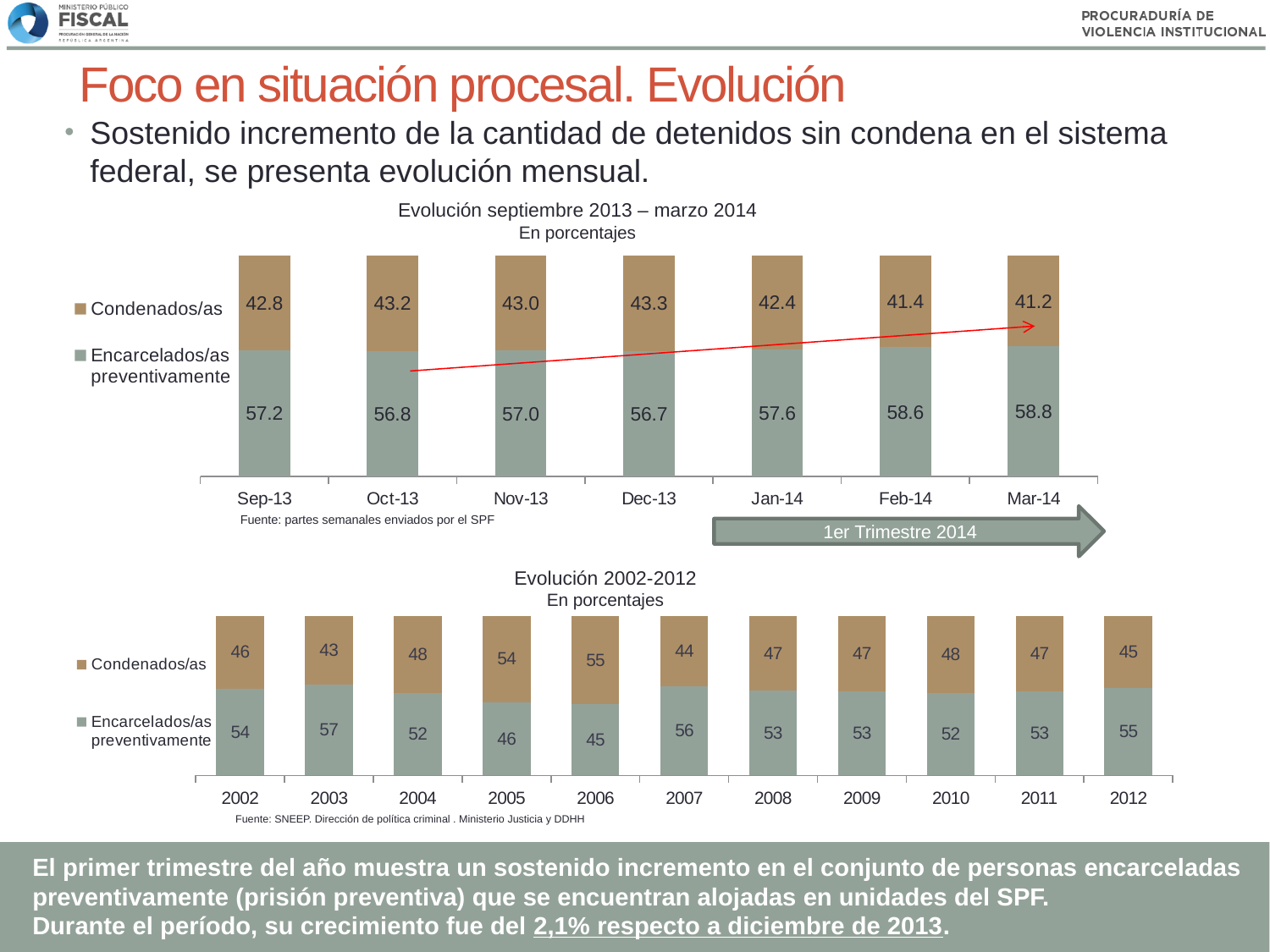
In the 'Evolución 2002-2012' chart, how many series does the legend list? 2 In the 'Evolución septiembre 2013 – marzo 2014' chart, which month has the highest value for Encarcelados/as preventivamente? Mar-14 In the 'Evolución 2002-2012' chart, what is the value for Condenados/as in 2006? 55 In the 'Evolución septiembre 2013 – marzo 2014' chart, what is the value for Encarcelados/as preventivamente in Mar-14? 58.8 What kind of chart is the 'Evolución 2002-2012' chart? stacked bar chart In the 'Evolución 2002-2012' chart, which year has the lowest value for Encarcelados/as preventivamente? 2006 In the 'Evolución septiembre 2013 – marzo 2014' chart, which month has the lowest value for Condenados/as? Mar-14 In the 'Evolución septiembre 2013 – marzo 2014' chart, what is the value for Condenados/as in Dec-13? 43.3 In the 'Evolución 2002-2012' chart, what is the value for Encarcelados/as preventivamente in 2003? 57 In the 'Evolución septiembre 2013 – marzo 2014' chart, how many months are shown on the x axis? 7 In the 'Evolución septiembre 2013 – marzo 2014' chart, what is the difference between the Encarcelados/as preventivamente values for Mar-14 and Dec-13? 2.1 In the 'Evolución 2002-2012' chart, is the Condenados/as value for 2005 larger or smaller than the value for 2007? larger